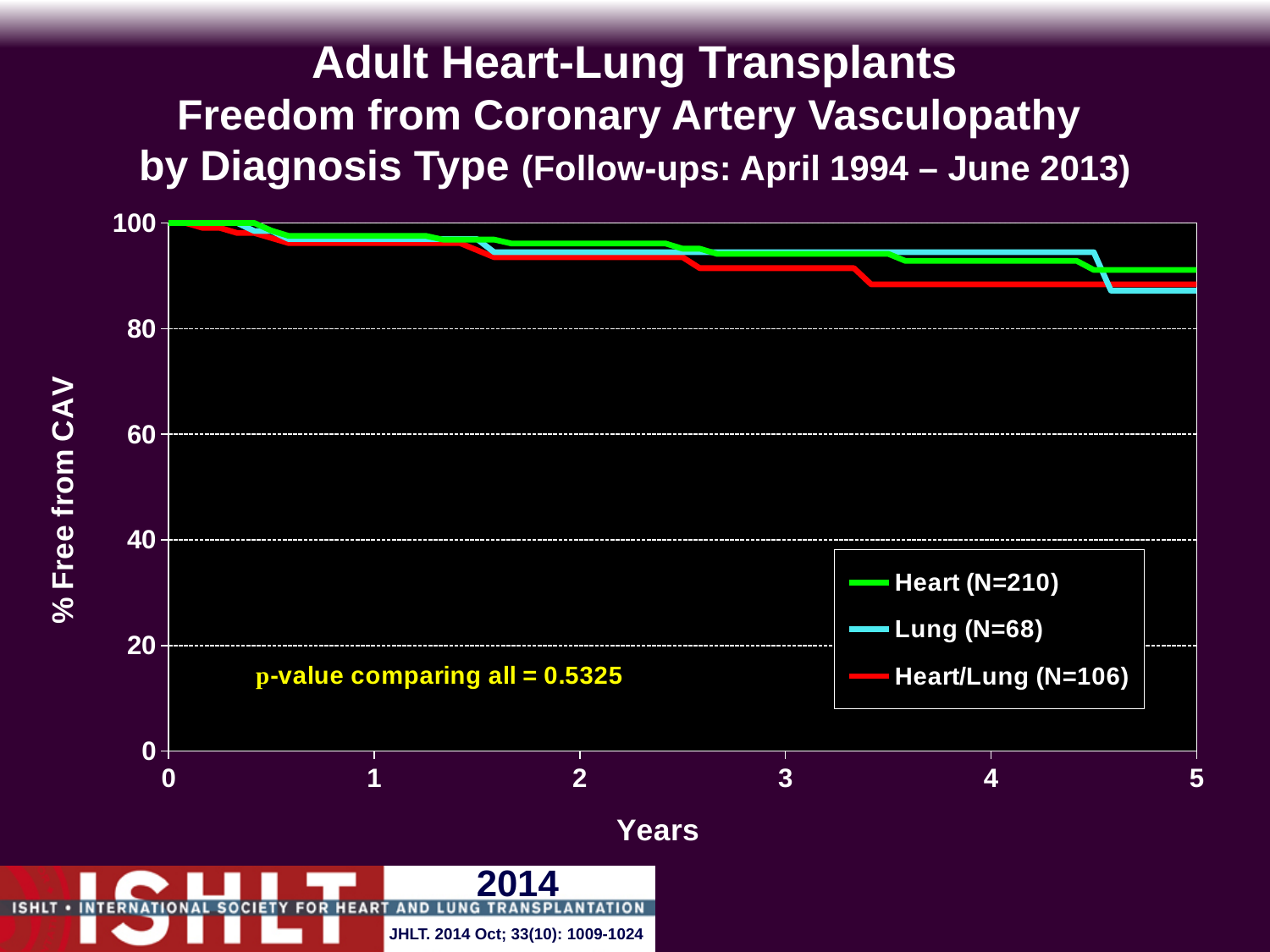
Is the value for Heart (N=210) at year 4 greater or less than 100? less What is the value for Heart (N=210) at year 0? 100 What p-value comparing all groups is shown on the chart? 0.5325 At year 5, which is larger: the value for Heart (N=210) or Heart/Lung (N=106)? Heart (N=210) Is the value for Lung (N=68) at year 2 greater or less than 80? greater At year 5, which series has the highest % free from CAV? Heart (N=210) How many series does the legend list? 3 What is the N for the Lung group in the legend? 68 Is the value for Heart/Lung (N=106) at year 5 greater or less than 80? greater At year 3, which is larger: the value for Heart (N=210) or Heart/Lung (N=106)? Heart (N=210) Do the values for Heart/Lung (N=106) rise or fall as years increase? fall What kind of chart is shown on the slide? line chart